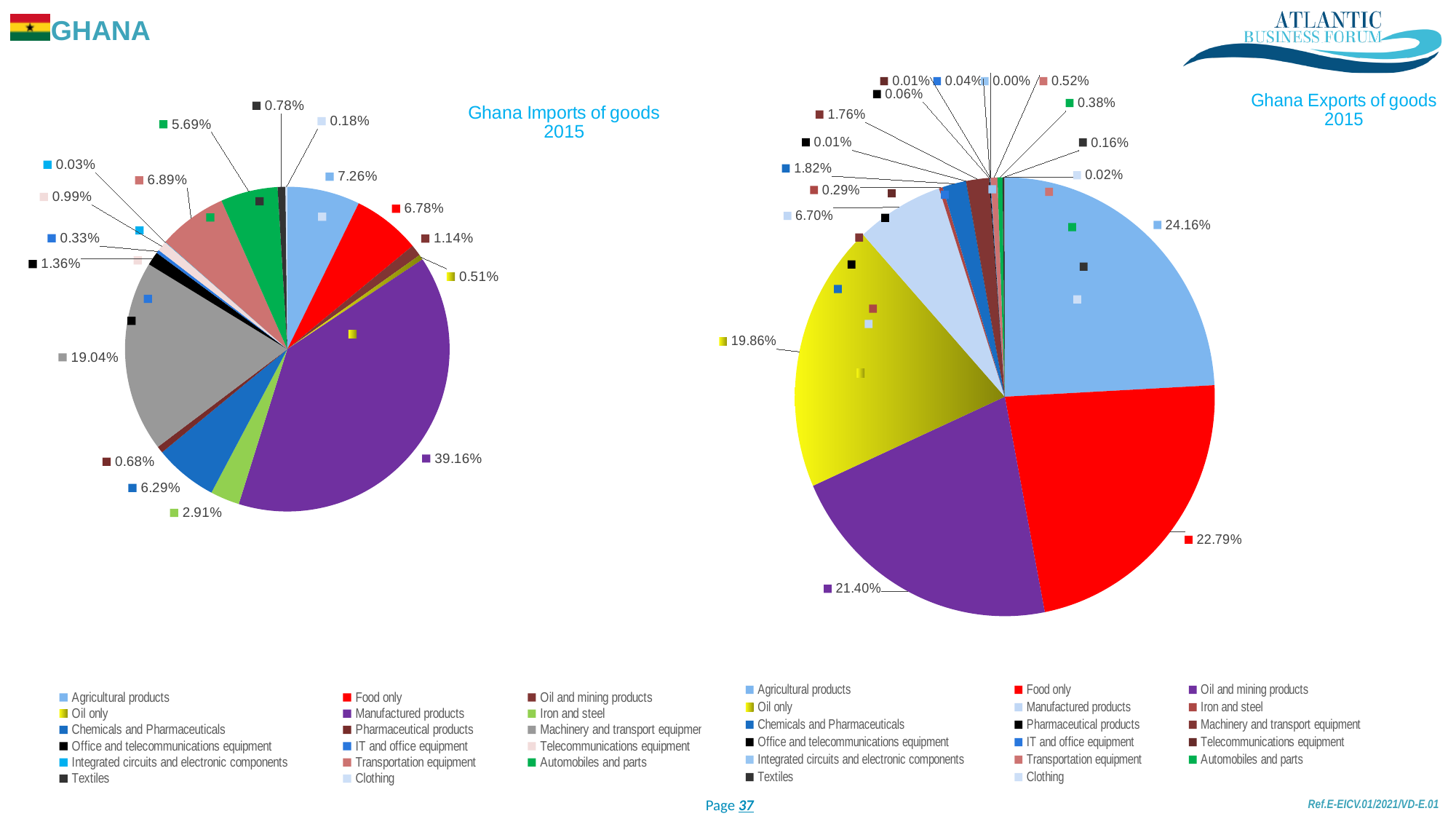
In the Ghana Exports of goods 2015 chart, which is larger: Oil and mining products or Oil only? Oil and mining products In the Ghana Imports of goods 2015 chart, which category has the largest share? Manufactured products In the Ghana Imports of goods 2015 chart, what share does Machinery and transport equipment have? 19.04% In the Ghana Exports of goods 2015 chart, which category has the largest share? Agricultural products In the Ghana Imports of goods 2015 chart, which is larger: Agricultural products or Food only? Agricultural products In the Ghana Imports of goods 2015 chart, what is the difference between the Manufactured products share and the Machinery and transport equipment share? 20.12% How many categories does the legend of the Ghana Exports of goods 2015 chart list? 17 In the Ghana Exports of goods 2015 chart, what share does Oil only have? 19.86% In the Ghana Imports of goods 2015 chart, what share do Manufactured products have? 39.16% What type of chart is used for Ghana Imports of goods 2015? Pie chart In the Ghana Exports of goods 2015 chart, what share do Agricultural products have? 24.16% In the Ghana Exports of goods 2015 chart, what is the difference between the Agricultural products share and the Food only share? 1.37%